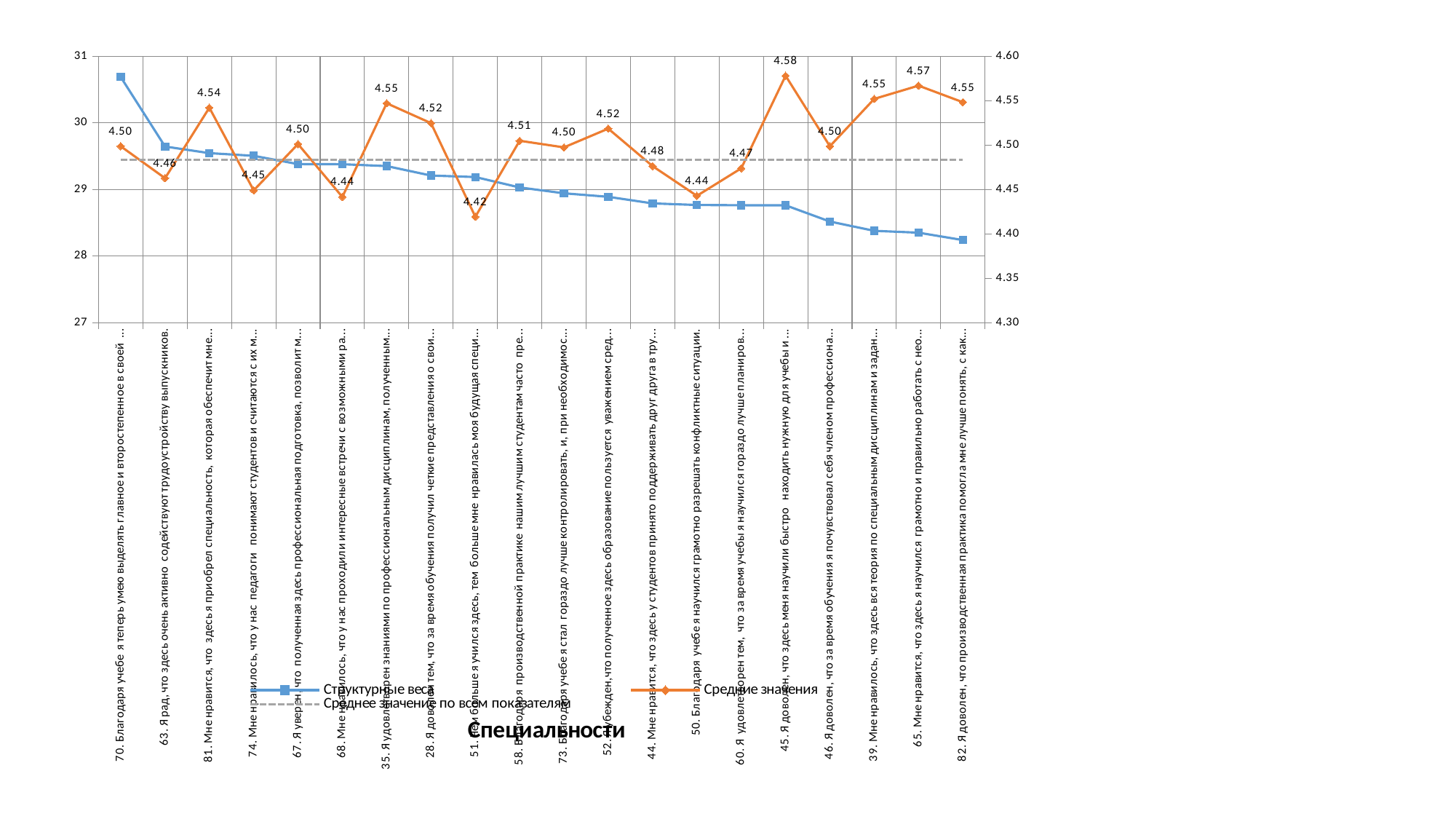
Which statement has the lowest value in the 'Средние значения' series? 51. …чем больше я учился здесь, тем больше мне нравилась моя будущая специ… Does the 'Структурные веса' series generally rise or fall from left to right along the x axis? fall Which statement has the highest value in the 'Средние значения' series? 45. Я доволен, что здесь меня научили быстро находить нужную для учебы и… What is the difference between the 'Средние значения' values for statement 65 (4.57) and statement 63 (4.46)? 0.11 What kind of chart is shown on the slide? line chart How many series does the legend list? 3 Is the 'Структурные веса' value for the first statement (70) greater or less than 30? greater Which has a larger 'Средние значения' value: statement 81 or statement 74? 81 How many categories (statements) are plotted along the x axis? 20 What is the value of the 'Средние значения' series for statement 28 ('Я доволен тем, что за время обучения получил четкие представления о свои…')? 4.52 What is the value of the 'Средние значения' series for statement 45 ('Я доволен, что здесь меня научили быстро находить нужную для учебы и…')? 4.58 What is the value of the 'Средние значения' series for statement 51 ('…чем больше я учился здесь, тем больше мне нравилась моя будущая специ…')? 4.42